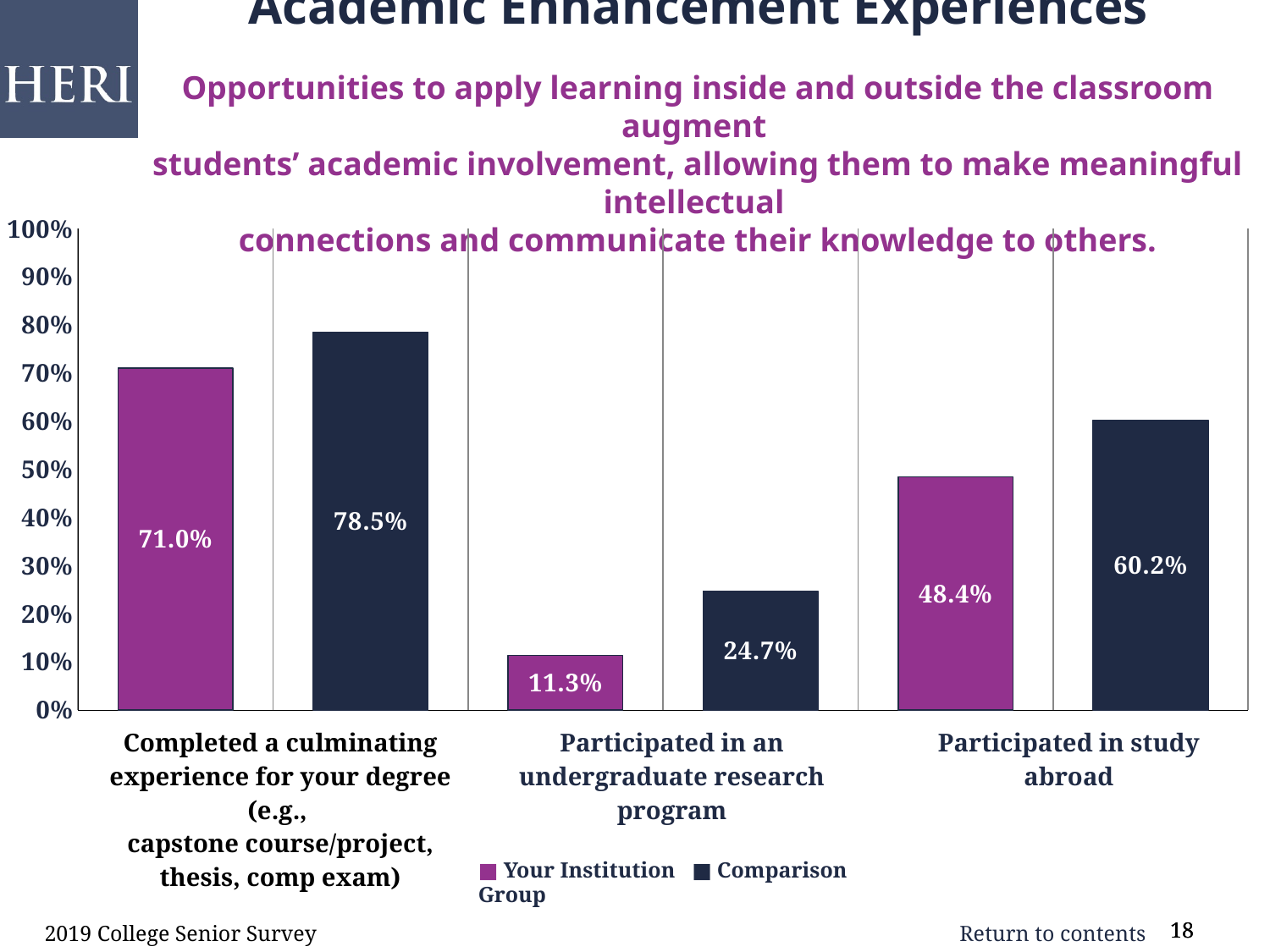
How many series does the legend list? 2 Is the Comparison Group value for 'Participated in study abroad' greater or less than 50%? greater How many categories are shown on the x axis? 3 What is the value for Comparison Group for 'Participated in an undergraduate research program'? 24.7% What is the value for Your Institution for 'Completed a culminating experience for your degree'? 71.0% What is the title of the chart? Academic Enhancement Experiences What is the value for Your Institution for 'Participated in study abroad'? 48.4% What is the difference between the Comparison Group and Your Institution values for 'Participated in study abroad'? 11.8% Which category has the highest value for the Comparison Group? Completed a culminating experience for your degree What kind of chart is shown on the slide? bar chart Which category has the lowest value for Your Institution? Participated in an undergraduate research program For 'Completed a culminating experience for your degree', which series has the larger value, Your Institution or Comparison Group? Comparison Group